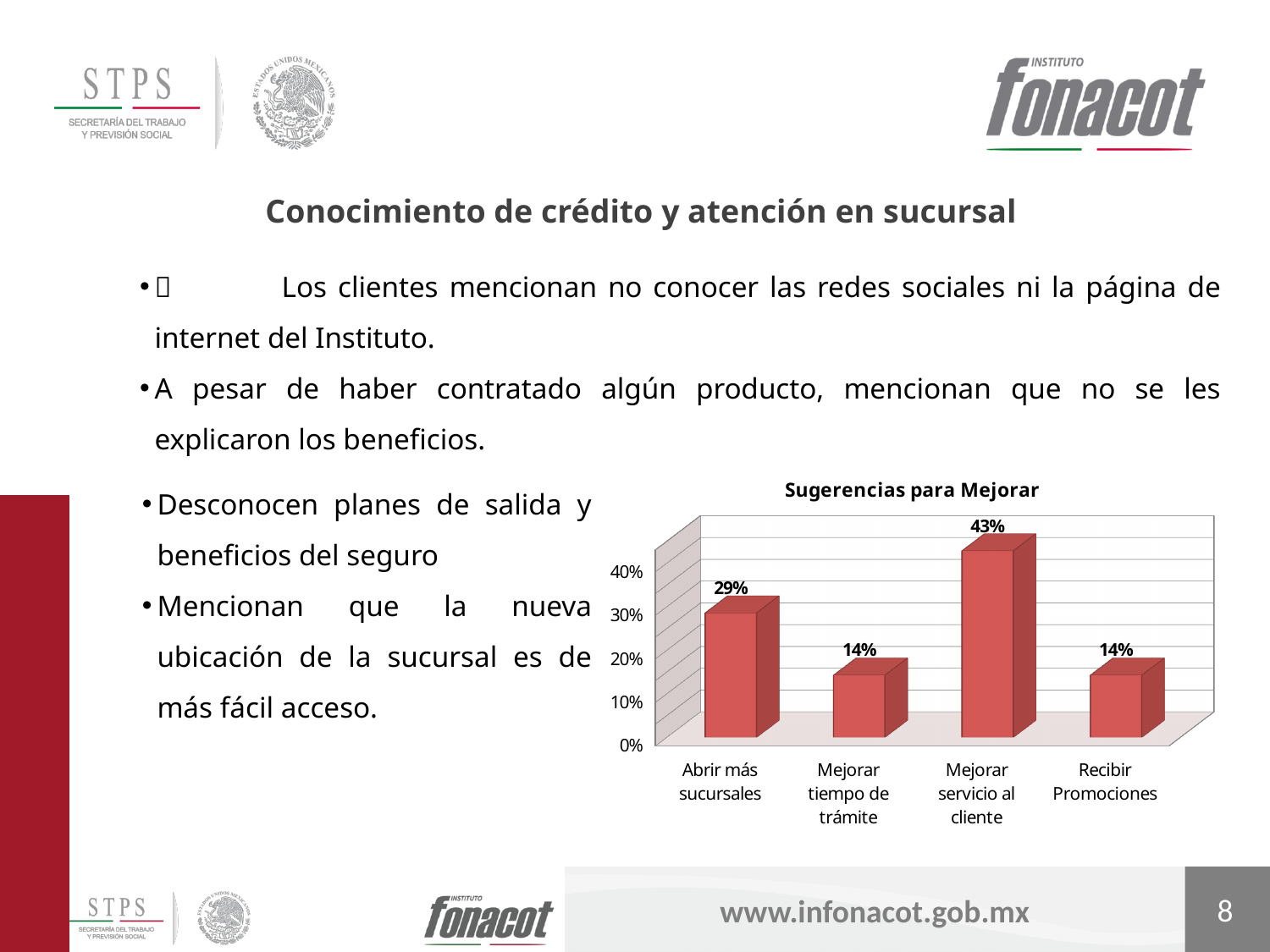
What is the title of the chart on the slide? Sugerencias para Mejorar How many categories are shown in the Sugerencias para Mejorar chart? 4 What is the difference between the values for "Abrir más sucursales" and "Mejorar tiempo de trámite"? 15% Which is larger, the value for "Abrir más sucursales" or the value for "Recibir Promociones"? Abrir más sucursales What kind of chart is the Sugerencias para Mejorar chart? Bar chart What is the value for "Mejorar servicio al cliente" in the Sugerencias para Mejorar chart? 43% Which category has the highest value in the Sugerencias para Mejorar chart? Mejorar servicio al cliente Is the value for "Mejorar servicio al cliente" greater or less than 40%? greater What is the value for "Abrir más sucursales" in the Sugerencias para Mejorar chart? 29% How many categories in the Sugerencias para Mejorar chart have a value of 14%? 2 What is the difference between the values for "Mejorar servicio al cliente" and "Abrir más sucursales"? 14% What is the value for "Recibir Promociones" in the Sugerencias para Mejorar chart? 14%